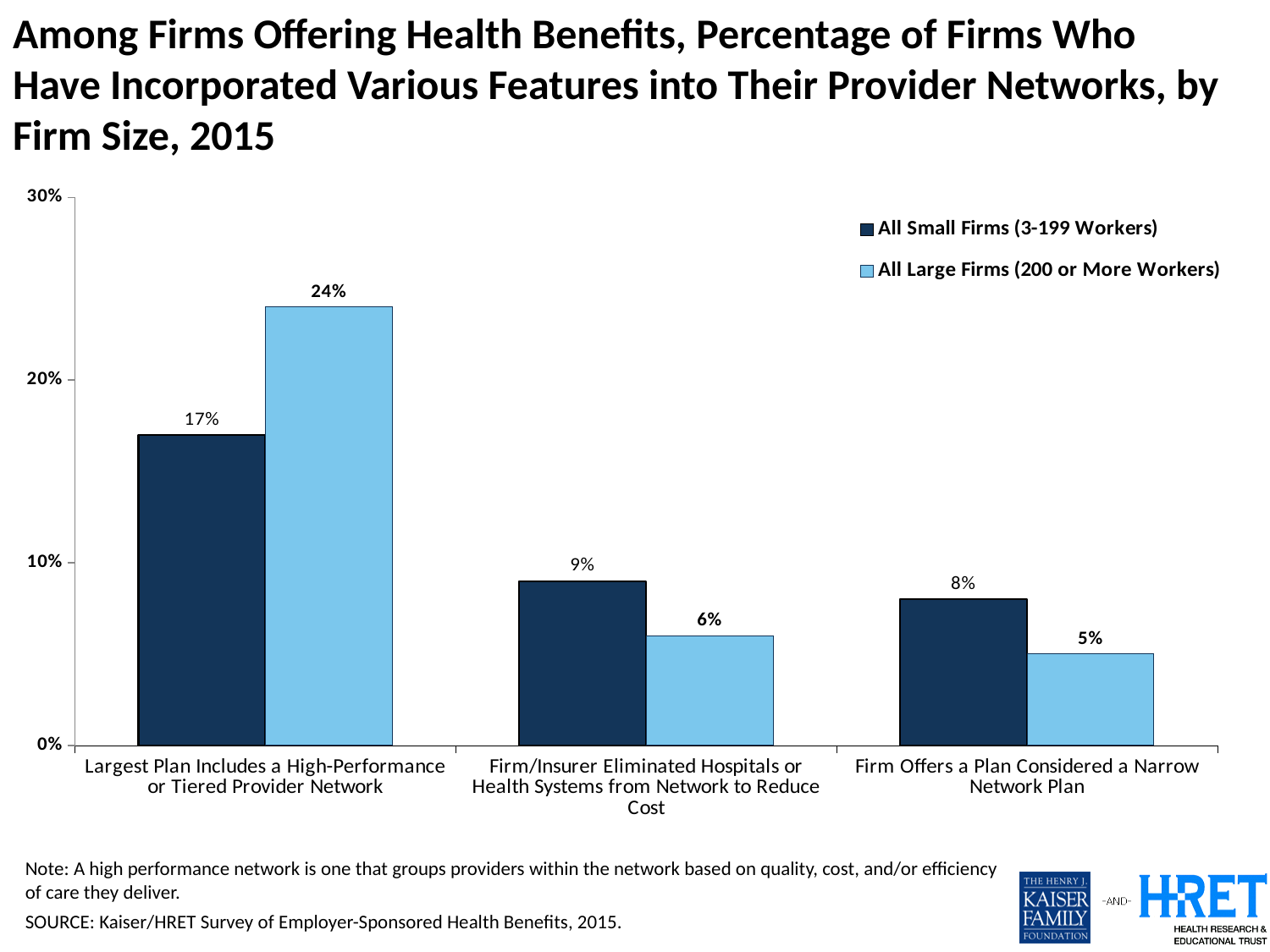
For 'Firm/Insurer Eliminated Hospitals or Health Systems from Network to Reduce Cost', which is larger: the value for All Small Firms or All Large Firms? All Small Firms (3-199 Workers) Is the value for All Large Firms in the 'Largest Plan Includes a High-Performance or Tiered Provider Network' category greater or less than 20%? greater What kind of chart is shown on the slide? Bar chart Which category has the highest value for All Large Firms (200 or More Workers)? Largest Plan Includes a High-Performance or Tiered Provider Network What is the value for All Large Firms (200 or More Workers) in the 'Firm Offers a Plan Considered a Narrow Network Plan' category? 5% What is the value for All Small Firms (3-199 Workers) in the 'Firm/Insurer Eliminated Hospitals or Health Systems from Network to Reduce Cost' category? 9% What is the difference between the large-firm and small-firm values for 'Largest Plan Includes a High-Performance or Tiered Provider Network'? 7% How many categories are shown on the x axis? 3 How many series does the legend list? 2 What percentage of All Small Firms (3-199 Workers) have a largest plan that includes a high-performance or tiered provider network? 17% Which category has the lowest value for All Small Firms (3-199 Workers)? Firm Offers a Plan Considered a Narrow Network Plan What percentage of All Large Firms (200 or More Workers) have a largest plan that includes a high-performance or tiered provider network? 24%